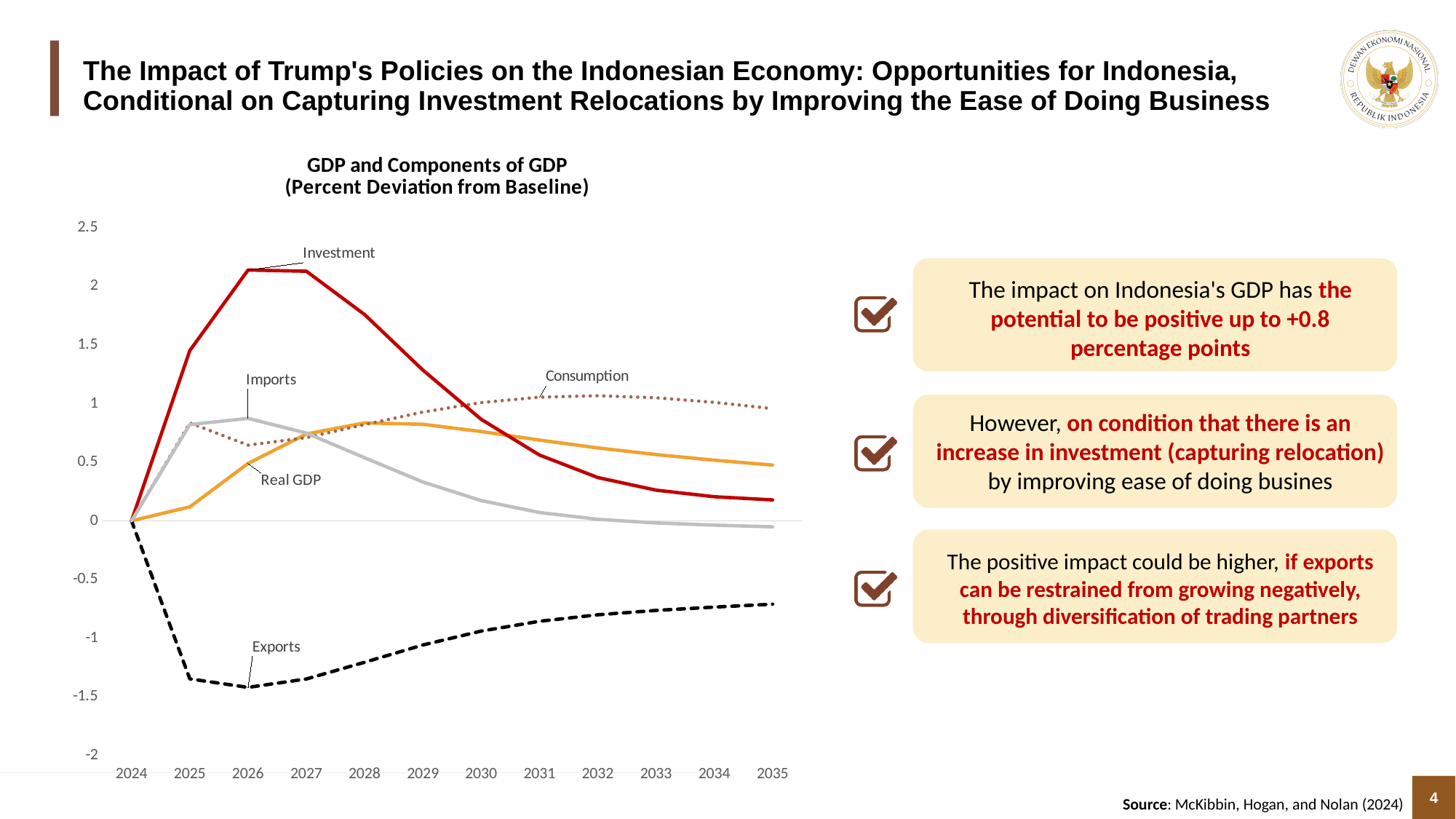
Is the value for Real GDP in 2029 greater or less than 0.5? greater Is the value for Exports in 2026 greater or less than -1? less What is the title of the chart? GDP and Components of GDP (Percent Deviation from Baseline) How many series are plotted in the chart? 5 Does the Investment series rise or fall from 2026 to 2035? fall Which is larger in 2027, Investment or Real GDP? Investment Which series has the lowest value in 2026? Exports Does the Exports series rise or fall from 2026 to 2035? rise How many years are shown on the x axis of the chart? 12 Which series reaches the highest value in the chart? Investment Is the value for Investment in 2027 greater or less than 1.5? greater What kind of chart is shown on the slide? line chart